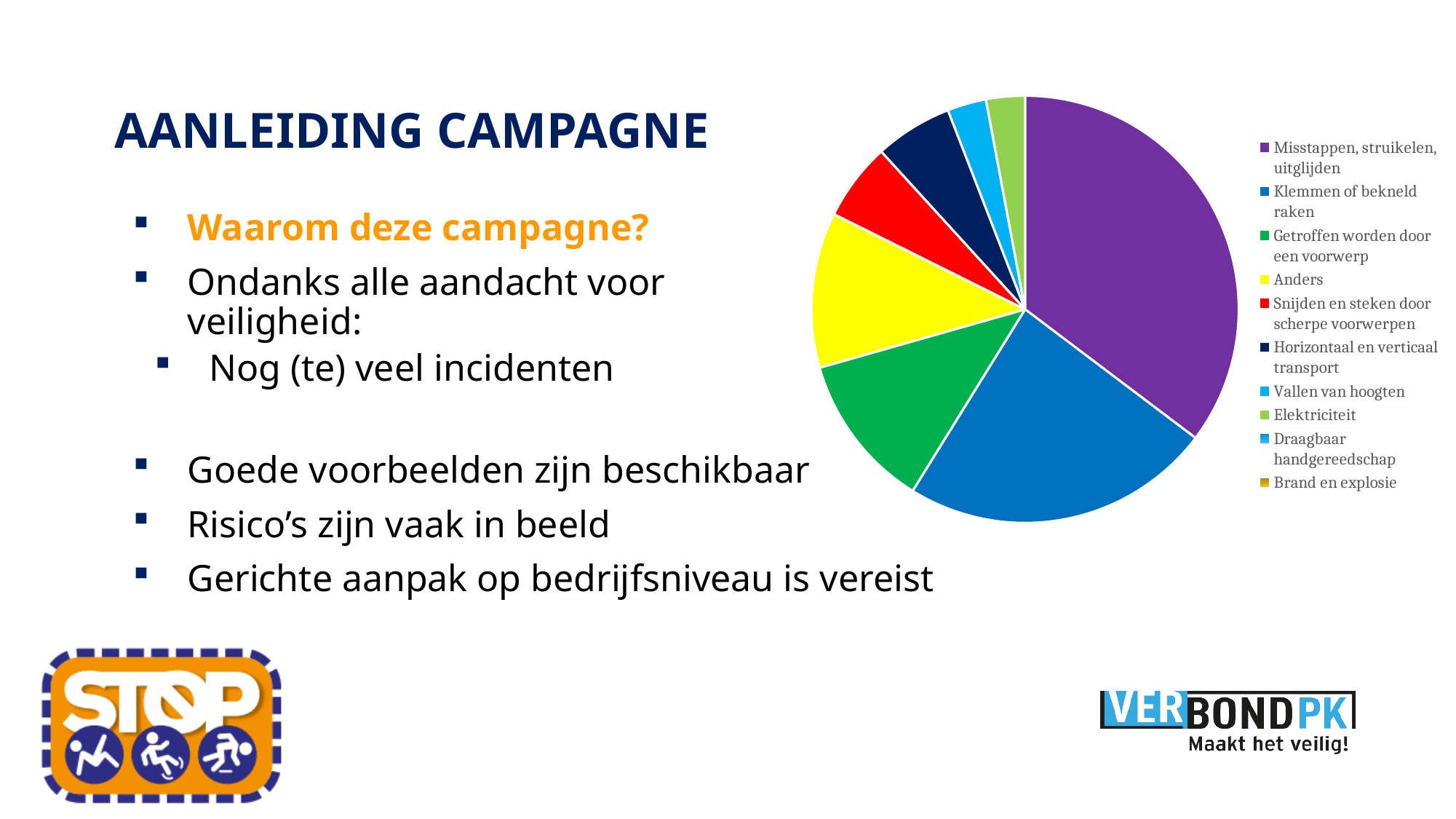
Which category is listed last in the pie chart's legend? Brand en explosie What kind of chart is shown on the slide? Pie chart Which slice is larger: Anders or Snijden en steken door scherpe voorwerpen? Anders Which slice is larger: Horizontaal en verticaal transport or Elektriciteit? Horizontaal en verticaal transport What colour represents the category Anders in the pie chart? Yellow Which slice is larger: Misstappen, struikelen, uitglijden or Klemmen of bekneld raken? Misstappen, struikelen, uitglijden How many entries does the legend of the pie chart list? 10 Which category has the largest slice in the pie chart? Misstappen, struikelen, uitglijden